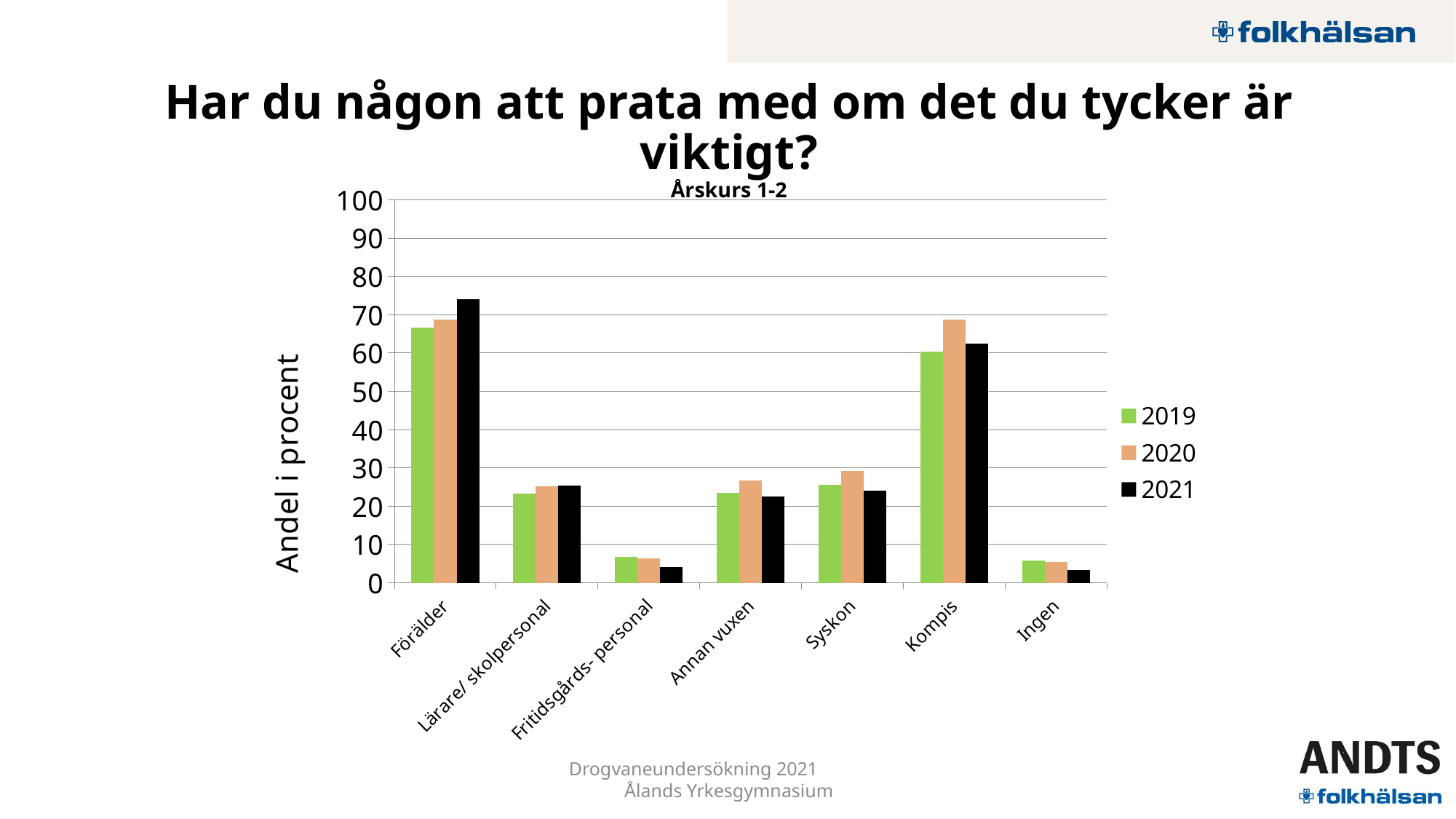
What is the title of the chart? Årskurs 1-2 How many series does the legend list? 3 Is the value for Förälder in 2021 greater or less than 70? greater For Kompis, which year has the larger value, 2020 or 2021? 2020 Is the value for Kompis in 2019 greater or less than 70? less Is the value for Annan vuxen in 2020 greater or less than 20? greater Do the values for Förälder rise or fall from 2019 to 2021? rise Which category has the highest value for 2021? Förälder How many categories are shown on the x axis? 7 Which category has the lowest value for 2021? Ingen What kind of chart is shown on the slide? bar chart